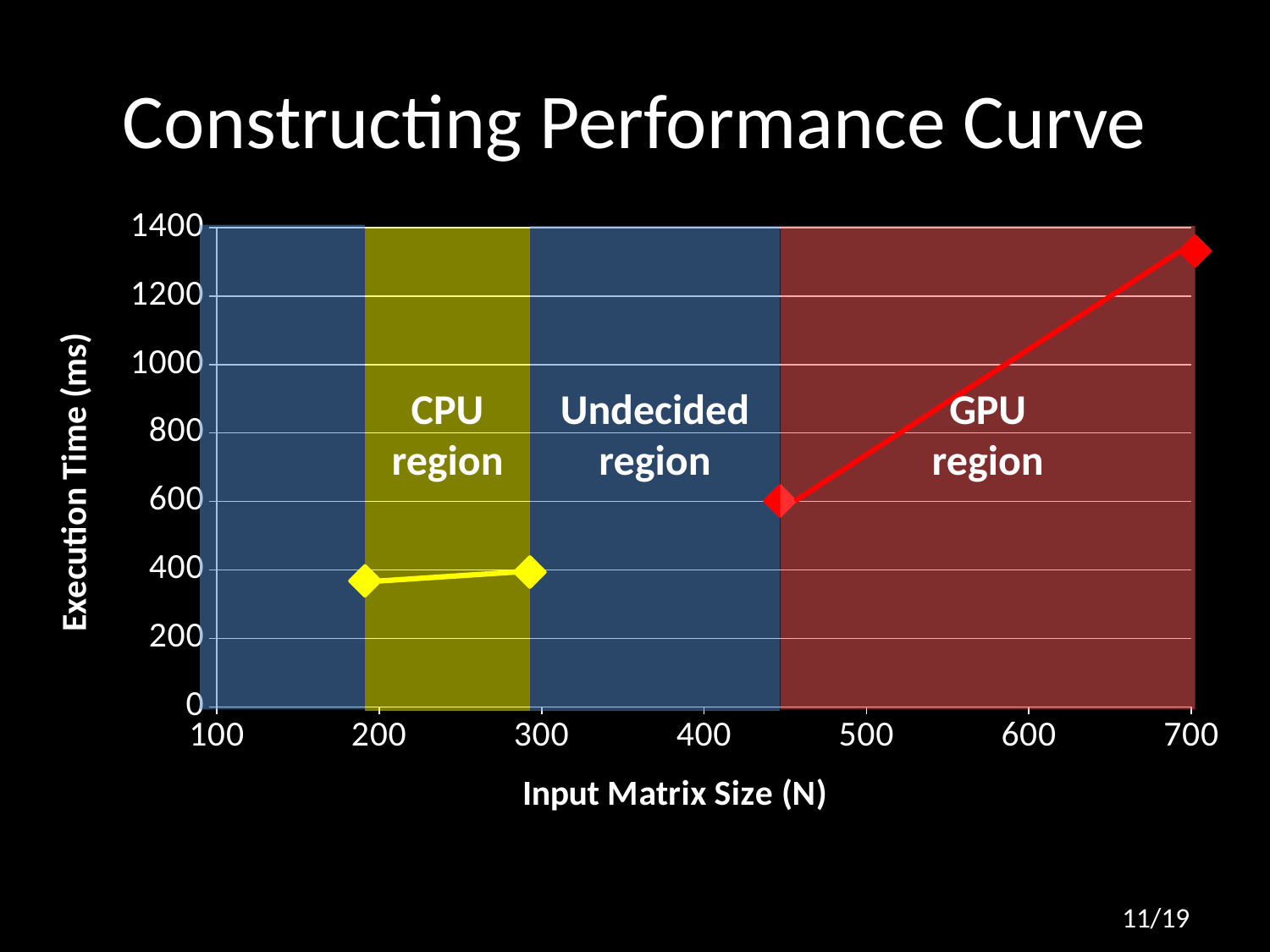
What is the title of the chart's x axis? Input Matrix Size (N) In which labelled region does the highest plotted execution time occur? GPU region Is the execution time of the leftmost yellow point (near N = 200) greater or less than 200? greater Is the execution time of the red point near N = 450 greater or less than 1000? less Which is larger: the execution time of the red point near N = 450 or the yellow point near N = 200? the red point near N = 450 How many plotted data points are shown on the chart? 4 Which is larger: the execution time of the red point near N = 700 or the yellow point near N = 300? the red point near N = 700 Does the red line rise or fall as the input matrix size increases from about 450 to 700? rises Is the execution time of the leftmost yellow point (near N = 200) greater or less than 600? less What kind of chart is shown on the slide? line chart What are the three labelled regions on the chart, from left to right? CPU region, Undecided region, GPU region